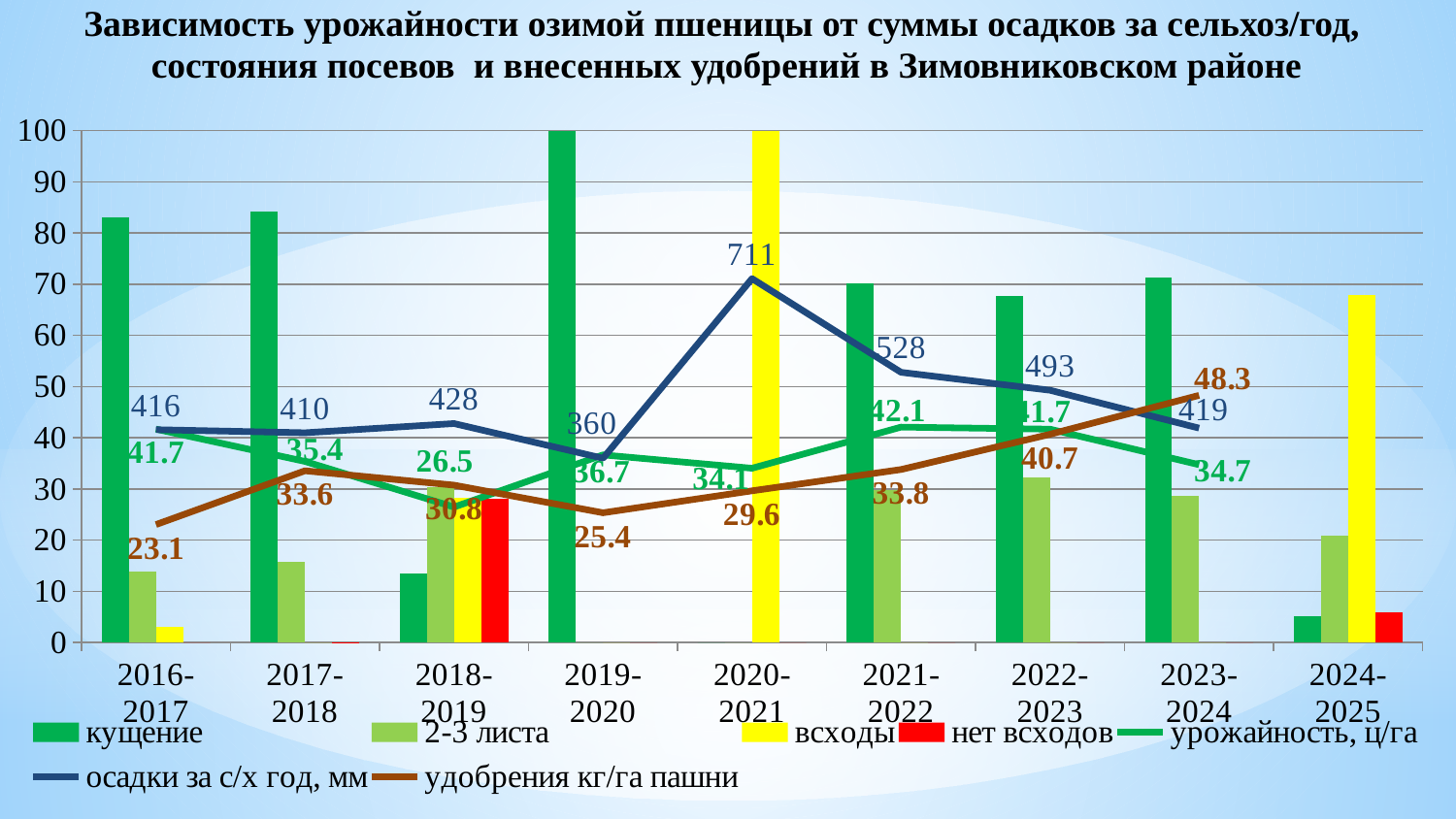
Which season has the higher урожайность, ц/га: 2020-2021 or 2021-2022? 2021-2022 In which season is осадки за с/х год, мм the highest? 2020-2021 In which season is the labelled value of осадки за с/х год, мм the lowest? 2019-2020 What is the value of удобрения кг/га пашни for 2023-2024? 48.3 What is the difference between осадки за с/х год, мм in 2020-2021 and in 2021-2022? 183 What is the value of осадки за с/х год, мм for 2020-2021? 711 What kind of chart is shown on the slide? combined bar and line chart How many series does the legend list? 7 Does удобрения кг/га пашни rise or fall from 2019-2020 to 2023-2024? rise In which season is урожайность, ц/га the lowest? 2018-2019 How many seasons are shown on the x axis? 9 Is the value of the кущение bar for 2016-2017 greater or less than 70? greater